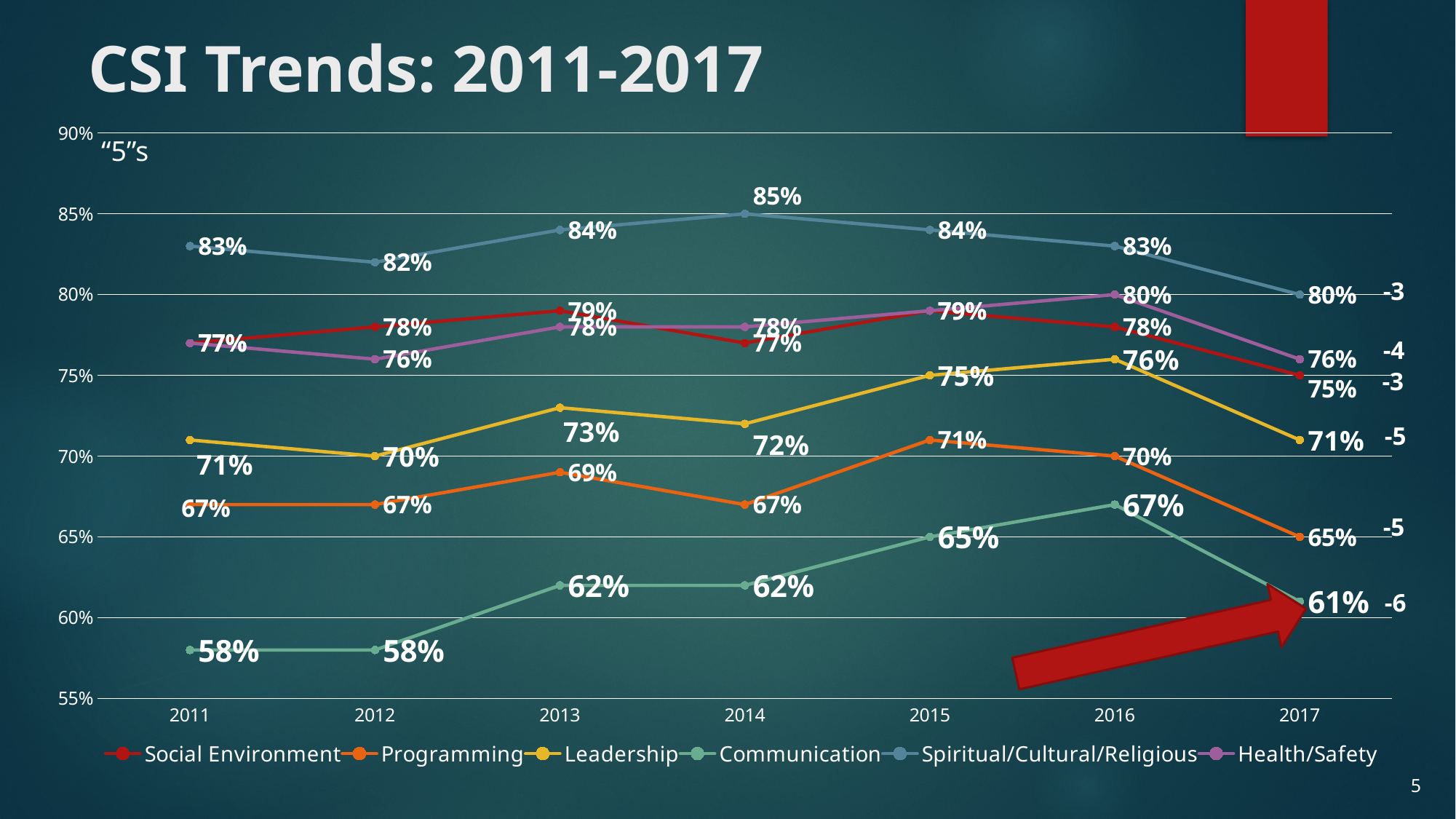
What kind of chart is shown on the slide? line chart Which series has the lowest value in 2011? Communication What is the title of the chart? CSI Trends: 2011-2017 How many series does the legend list? 6 How many years are plotted along the x axis? 7 By how many percentage points did Communication fall from 2016 to 2017? 6 In 2016, which is larger: Leadership or Programming? Leadership Does the Communication line rise or fall from 2011 to 2016? rise What is the value for Spiritual/Cultural/Religious in 2014? 85% What is the value for Programming in 2017? 65% Which series has the highest value in 2017? Spiritual/Cultural/Religious What is the value for Communication in 2017? 61%